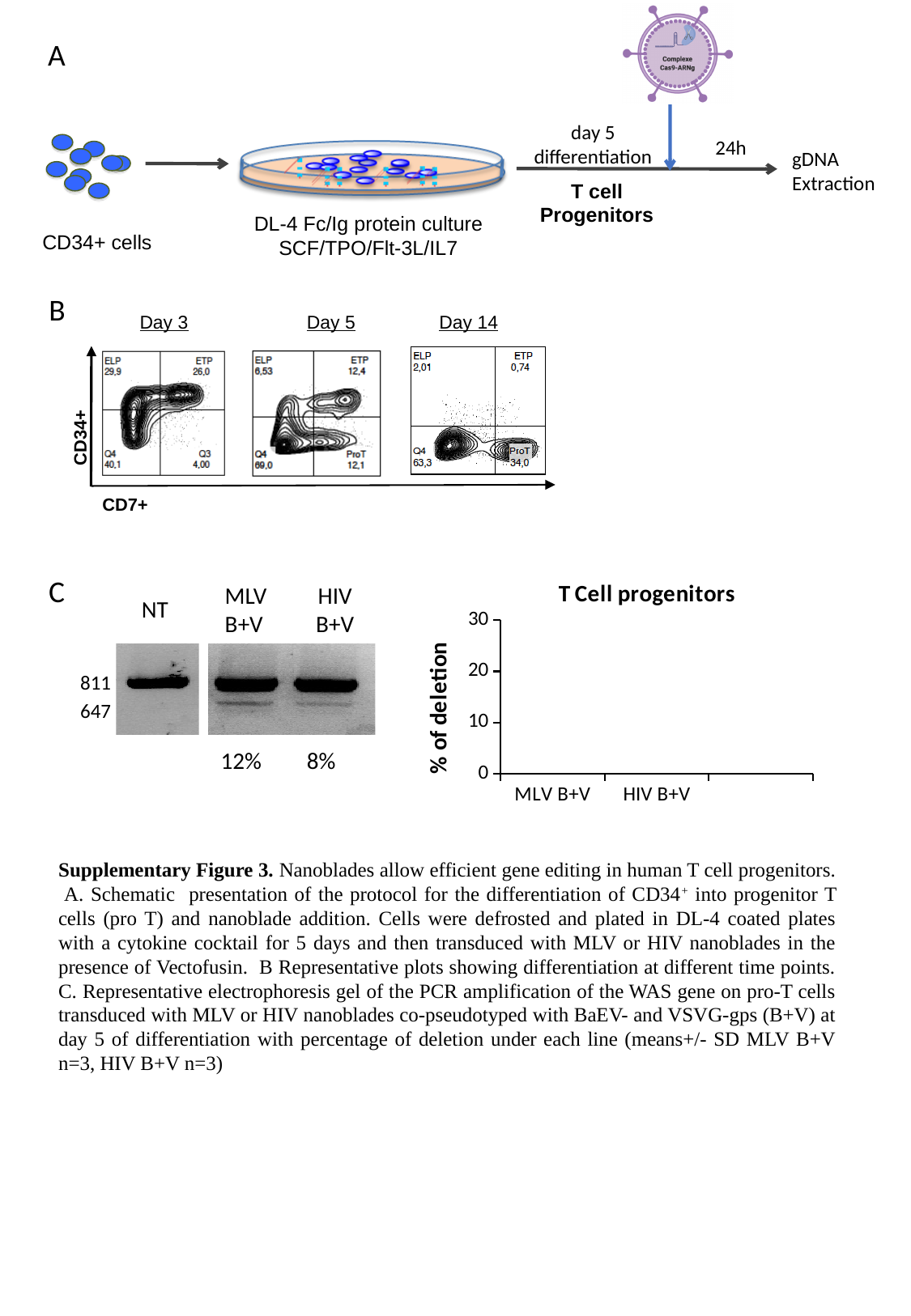
In the 'T Cell progenitors' chart, how many categories are labelled on the x axis? 2 In the Day 3 flow cytometry plot in panel B, what is the value printed for ELP? 29,9 In the Day 14 flow cytometry plot in panel B, what is the value printed for ProT? 34,0 In the Day 3 flow cytometry plot in panel B, what is the value printed for ETP? 26,0 Across the panel B flow cytometry plots, which day has the highest ETP value? Day 3 In the 'T Cell progenitors' chart, what is the label on the y axis? % of deletion In panel B, how many flow cytometry plots are shown? 3 In the Day 3 flow cytometry plot in panel B, what is the value printed for Q4? 40,1 Across the panel B flow cytometry plots, does the ETP value rise or fall from Day 3 to Day 14? fall In panel B, which is larger: the ELP value at Day 3 or the ELP value at Day 5? Day 3 In the Day 5 flow cytometry plot in panel B, what is the value printed for ETP? 12,4 What is the title of the chart at the bottom right of the slide? T Cell progenitors